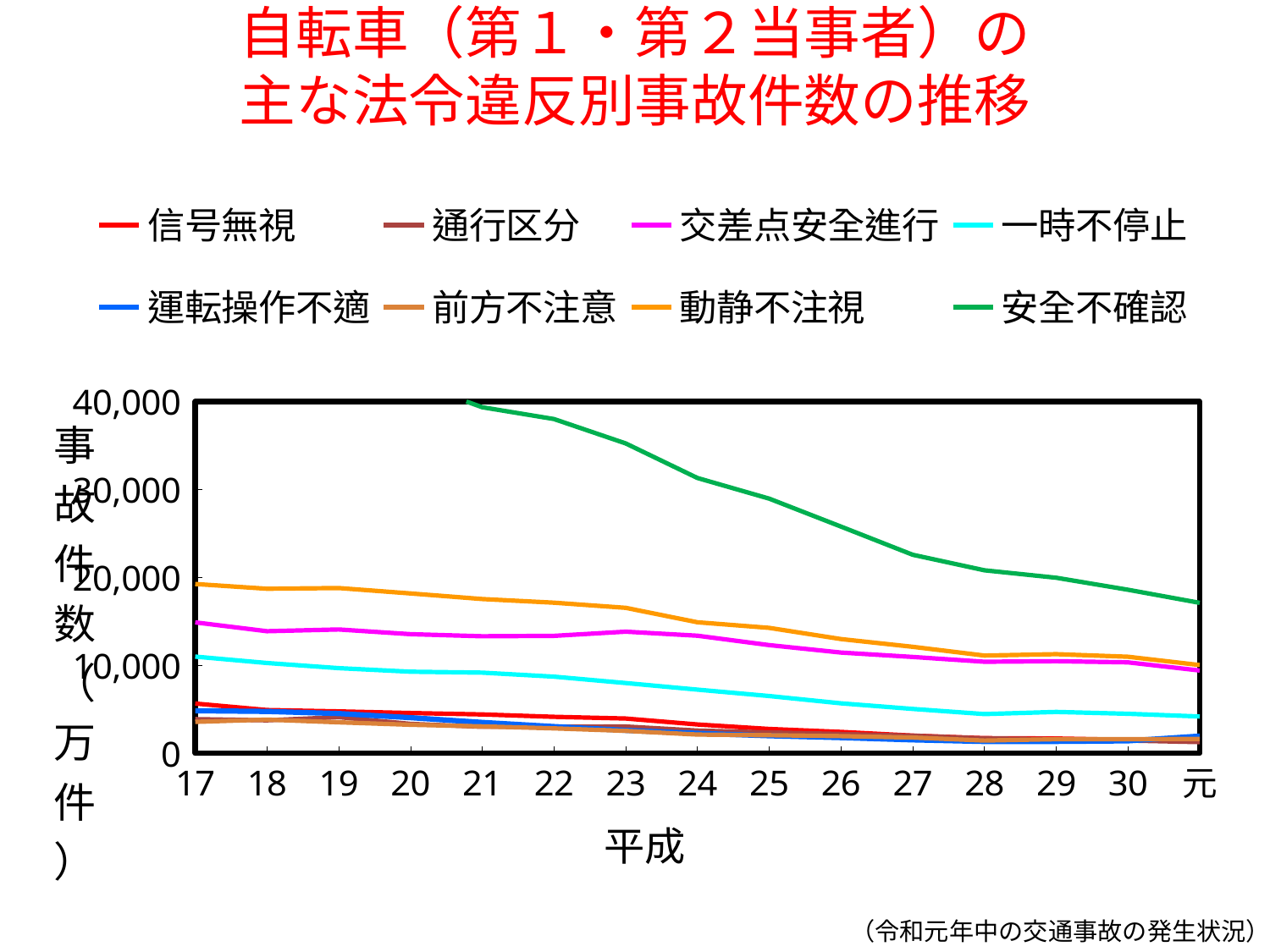
Does the value for 一時不停止 rise or fall from 17 to 元? fall What kind of chart is shown on the slide? line chart Does the value for 安全不確認 rise or fall from 21 to 元? fall Is the value for 交差点安全進行 at 17 greater or less than 10,000? greater Is the value for 安全不確認 at 23 greater or less than 30,000? greater Is the value for 安全不確認 at 元 greater or less than 10,000? greater Which series has the highest value at 元? 安全不確認 How many points are on the x axis of the chart? 15 What is the label of the x axis? 平成 At 17, which is larger: 動静不注視 or 交差点安全進行? 動静不注視 How many series does the legend list? 8